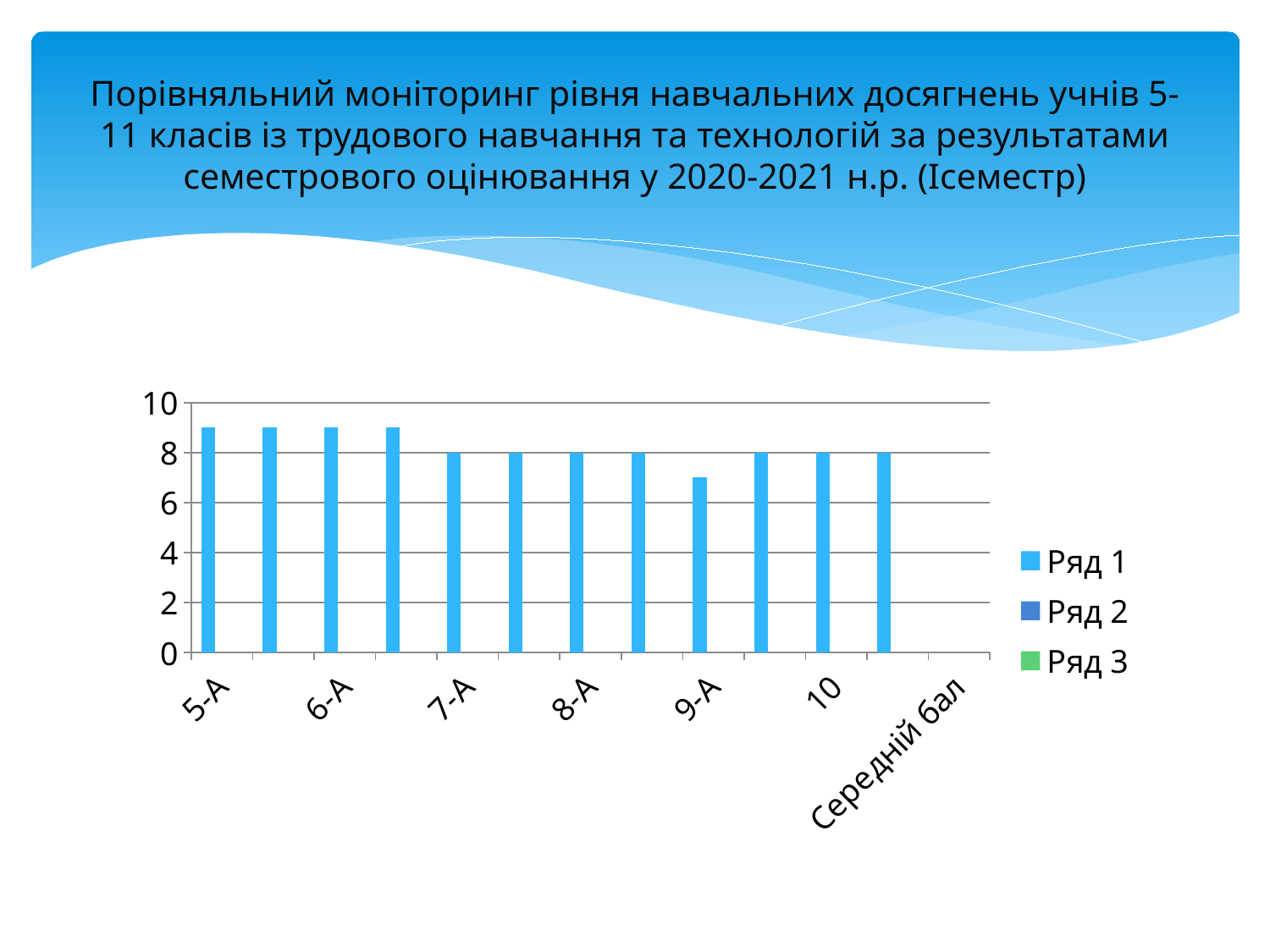
What is the name of the first series in the legend? Ряд 1 What is the value for 7-А? 8 Do the bar values generally rise or fall from left to right along the x axis? fall What is the value for 10? 8 Which is larger, the value for 6-А or the value for 8-А? 6-А Which labelled class has the lowest bar? 9-А How many series does the legend list? 3 Is the value for 9-А greater or less than 8? less What kind of chart is shown on the slide? bar chart